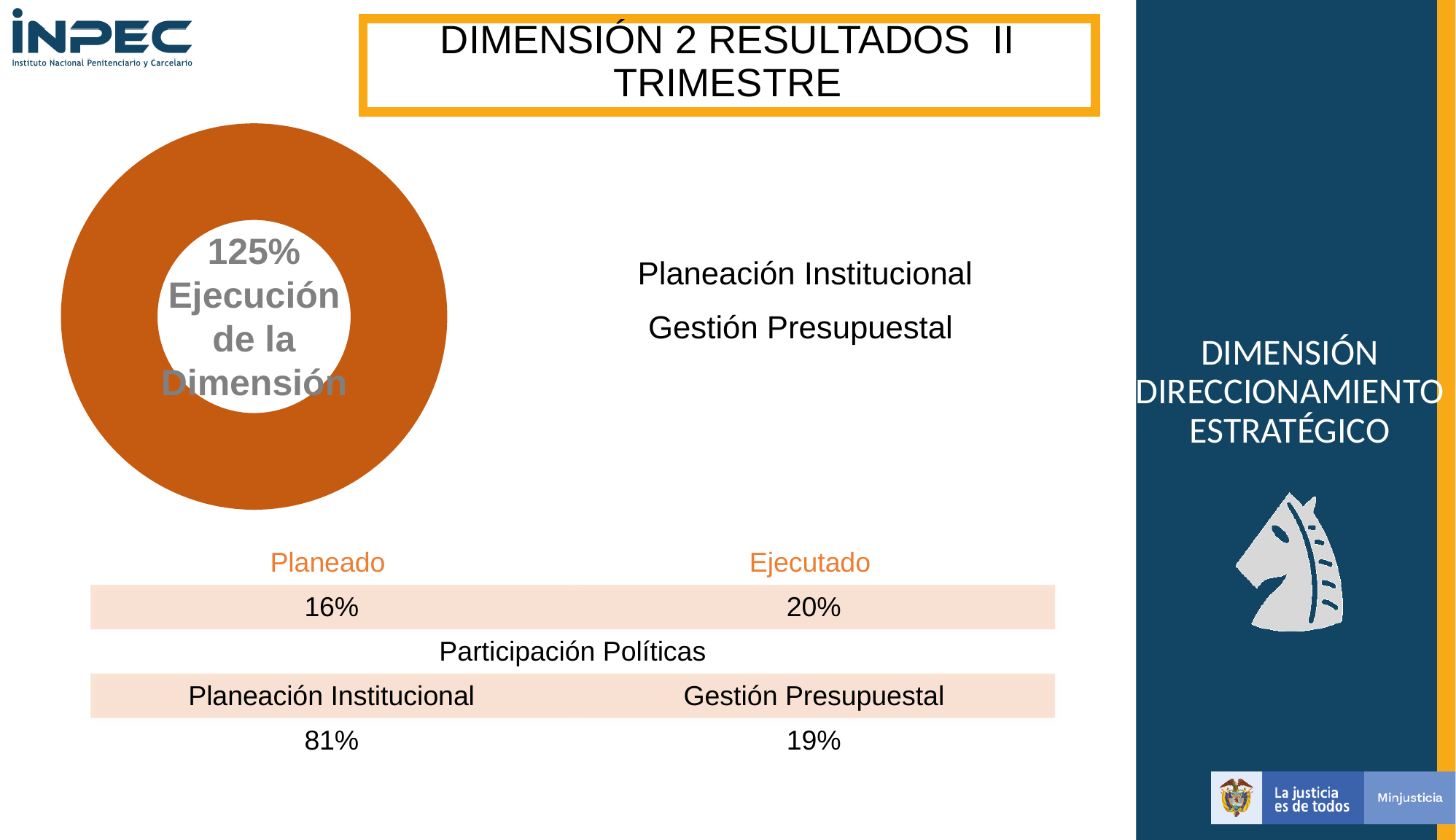
In the table below the donut chart, what is the Ejecutado value? 20% In the table below the donut chart, what is the difference between Ejecutado (20%) and Planeado (16%)? 4% What percentage is printed in the centre of the donut chart? 125% What kind of chart is shown on the left of the slide? Donut (pie) chart In the Participación Políticas table below the donut chart, what is the value for Planeación Institucional? 81% What colour is the ring of the donut chart? Orange Is the execution value shown in the centre of the donut chart greater or less than 100%? greater In the Participación Políticas table below the donut chart, what is the value for Gestión Presupuestal? 19% How many distinct slices are visible in the donut chart? 1 In the table below the donut chart, which is larger, Planeado or Ejecutado? Ejecutado What does the text in the centre of the donut chart say the 125% represents? Ejecución de la Dimensión In the table below the donut chart, what is the Planeado value? 16%